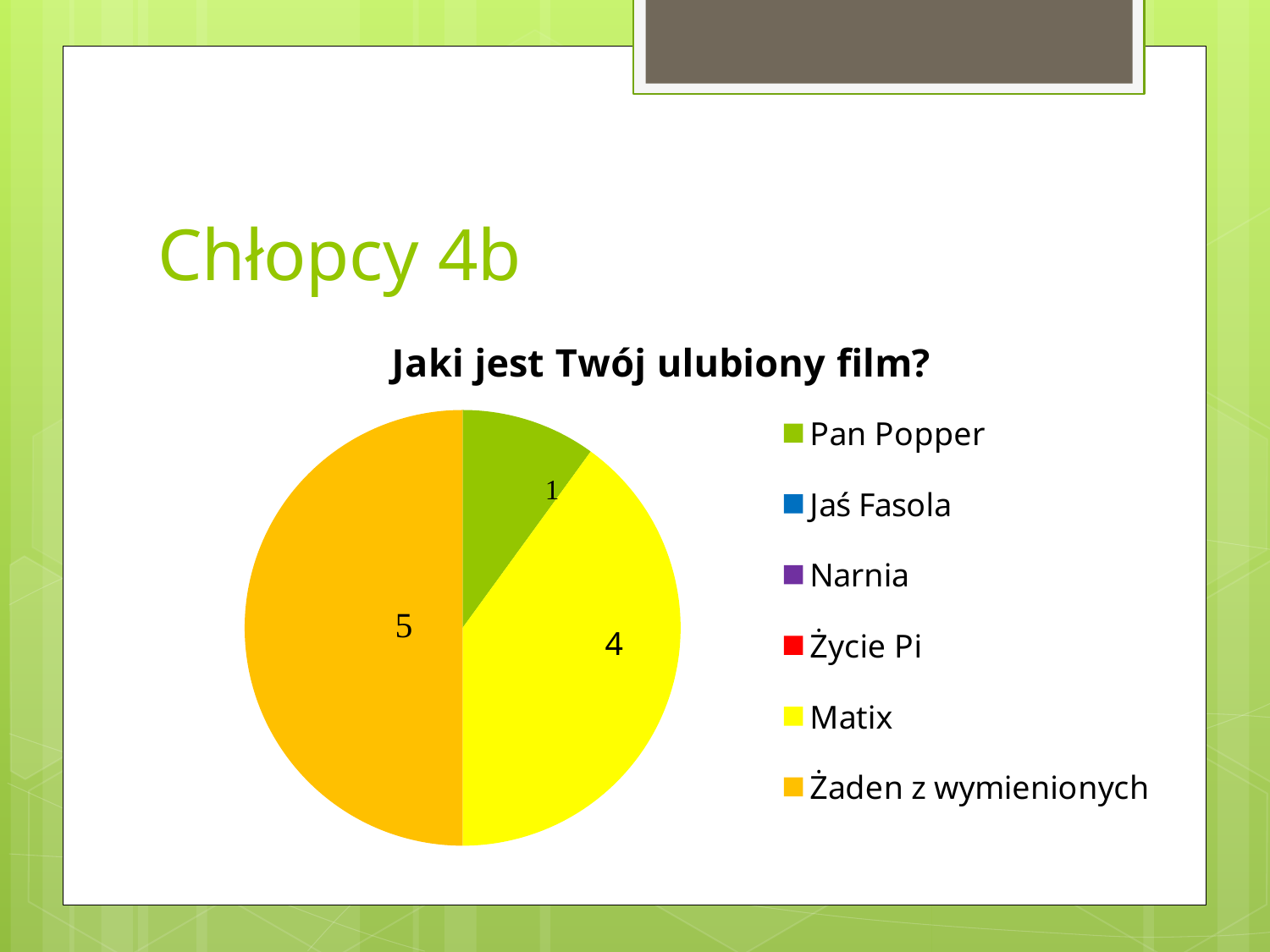
Which of the labelled slices is the smallest? Pan Popper What type of chart is shown on the slide? pie chart How many entries does the chart legend list? 6 What is the title of the chart? Jaki jest Twój ulubiony film? What is the value for Żaden z wymienionych? 5 What is the value for Pan Popper? 1 What is the total of the labelled slice values in the pie? 10 What is the difference between the values for Żaden z wymienionych and Matix? 1 Which is larger, the value for Matix or the value for Pan Popper? Matix What share of the labelled total does Żaden z wymienionych represent? 50% What is the value for Matix? 4 Which category has the largest slice of the pie? Żaden z wymienionych